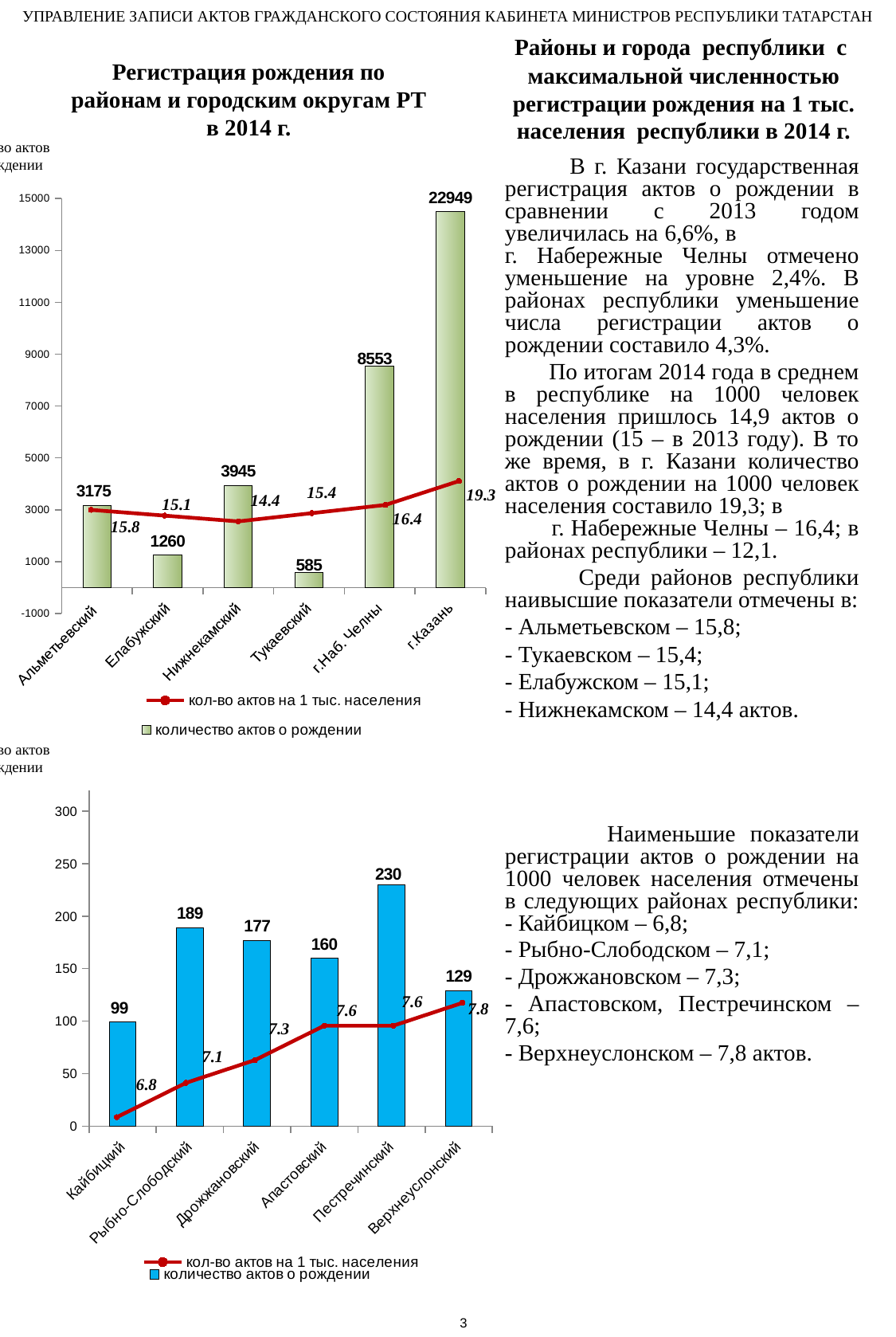
In the top chart, which is larger: the number of birth acts for Альметьевский or for Елабужский? Альметьевский In the bottom chart, what is the value of 'кол-во актов на 1 тыс. населения' for Кайбицкий? 6.8 In the top chart 'Регистрация рождения по районам и городским округам РТ в 2014 г.', what is the number of birth acts (количество актов о рождении) for г.Казань? 22949 In the top chart, what is the difference in the number of birth acts between г.Наб. Челны and Нижнекамский? 4608 In the bottom chart, does the line 'кол-во актов на 1 тыс. населения' rise or fall from Кайбицкий to Верхнеуслонский? rise In the top chart, how many series does the legend list? 2 In the top chart, what is the value of 'кол-во актов на 1 тыс. населения' for Тукаевский? 15.4 In the bottom chart, which category has the lowest number of birth acts? Кайбицкий In the bottom chart, what is the number of birth acts for Пестречинский? 230 In the top chart, which category has the lowest number of birth acts? Тукаевский In the bottom chart, how many categories are shown on the x axis? 6 In the top chart, what is the value of 'кол-во актов на 1 тыс. населения' for г.Казань? 19.3